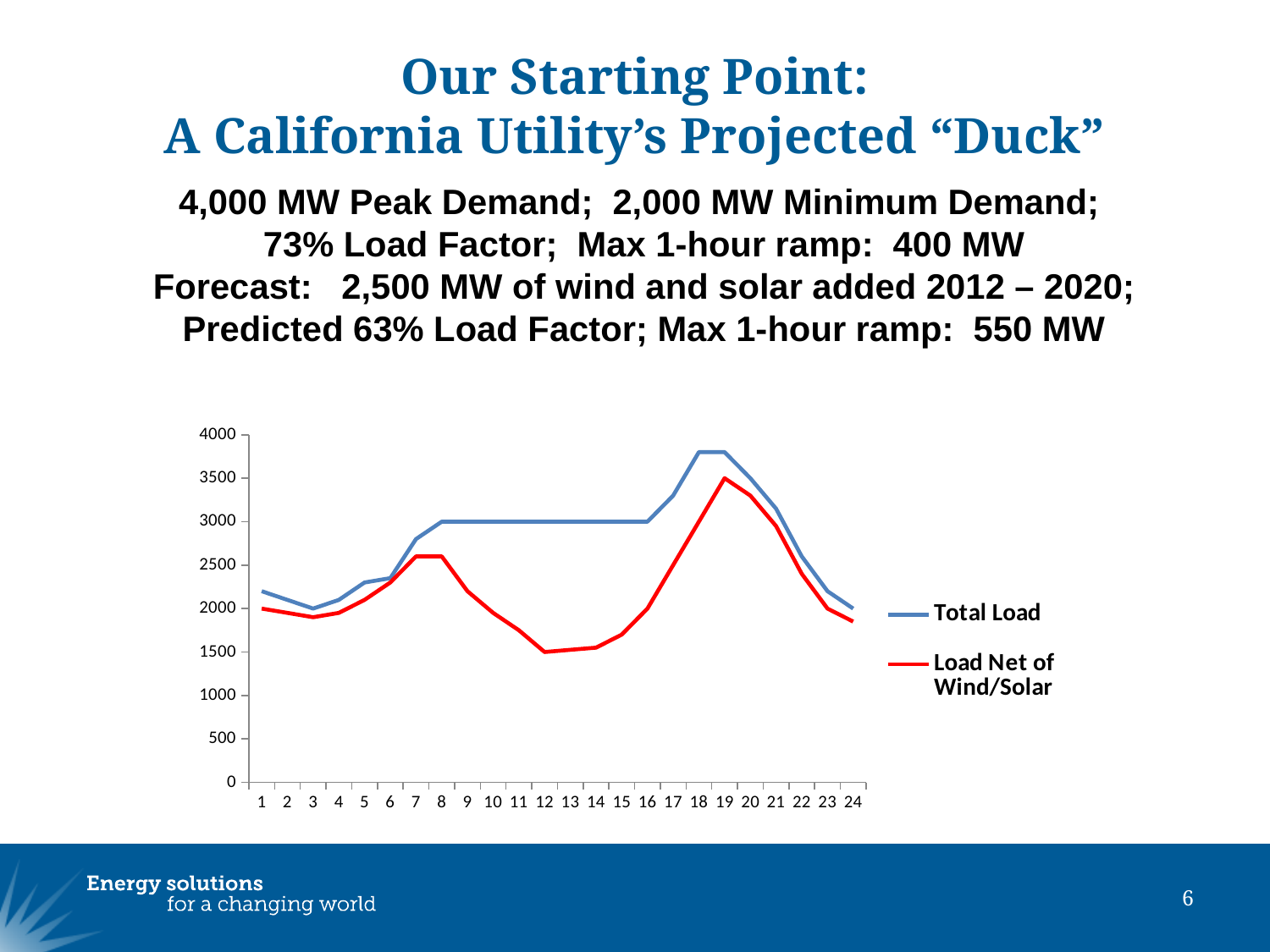
At hour 12, which series is higher: Total Load or Load Net of Wind/Solar? Total Load Is the Load Net of Wind/Solar value at hour 19 greater or less than 3000? greater Is the Total Load value at hour 18 greater or less than 3500? greater Between hour 8 and hour 12, does the Load Net of Wind/Solar series rise or fall? fall Is the Load Net of Wind/Solar value at hour 12 greater or less than 2000? less What is the Total Load value at hour 10? 3000 How many points (hours) are plotted along the x axis of the chart? 24 How many series does the chart's legend list? 2 What colour is the Total Load line in the chart? blue What kind of chart is shown on the slide? line chart At which hour does the Load Net of Wind/Solar series reach its highest value? 19